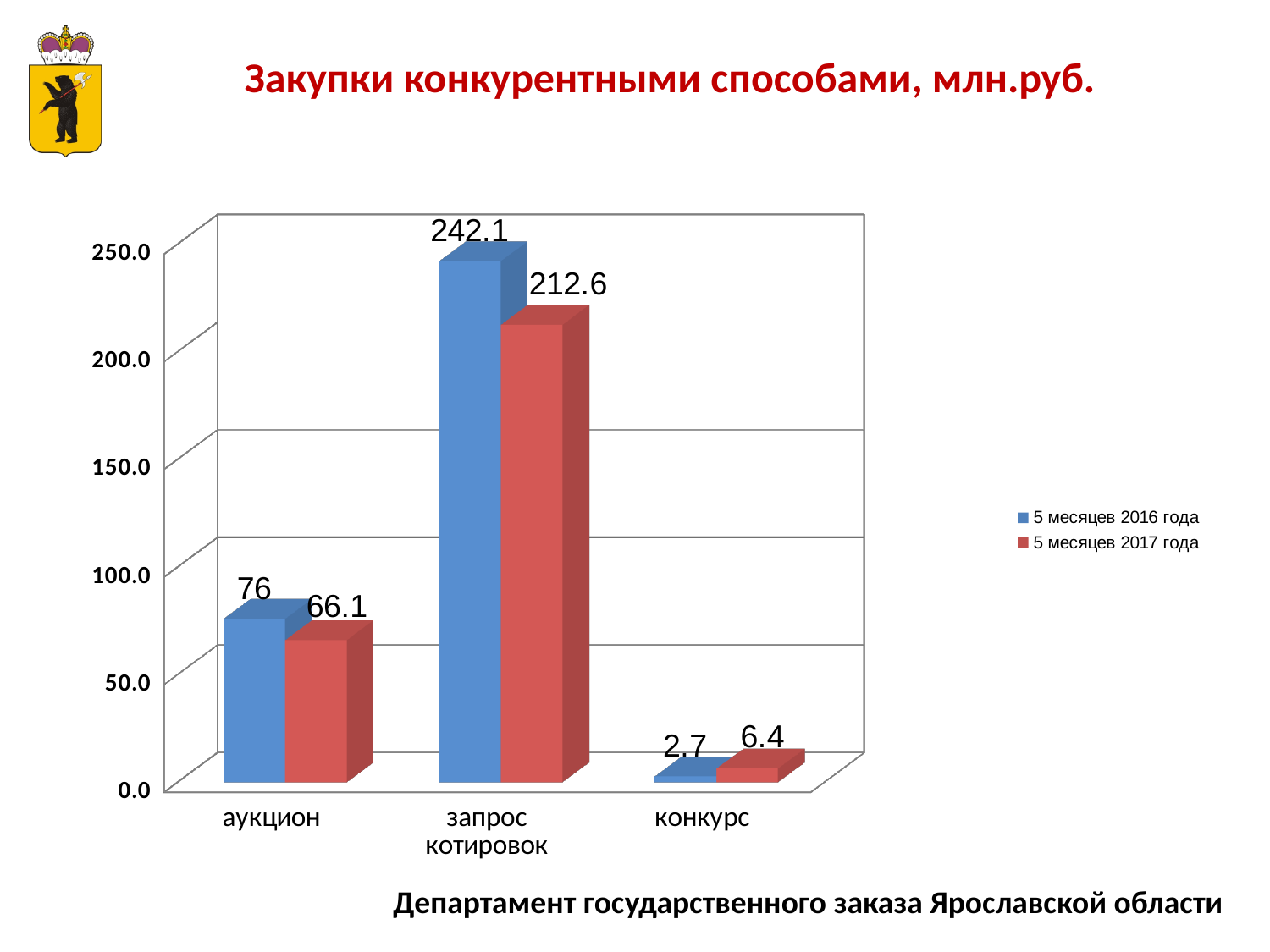
What is the difference between the 2016 and 2017 values for запрос котировок? 29.5 What is the value for аукцион in the series 5 месяцев 2016 года? 76 What kind of chart is shown on the slide? bar chart How many series does the legend list? 2 How many categories are shown on the x axis? 3 Which category has the lowest value in the series 5 месяцев 2017 года? конкурс Which category has the highest value in the series 5 месяцев 2016 года? запрос котировок Which is larger for конкурс: the value for 5 месяцев 2016 года or 5 месяцев 2017 года? 5 месяцев 2017 года Is the value for запрос котировок in 5 месяцев 2017 года greater or less than 200.0? greater What is the value for запрос котировок in the series 5 месяцев 2017 года? 212.6 What is the difference between the 2016 and 2017 values for аукцион? 9.9 What is the value for конкурс in the series 5 месяцев 2016 года? 2.7